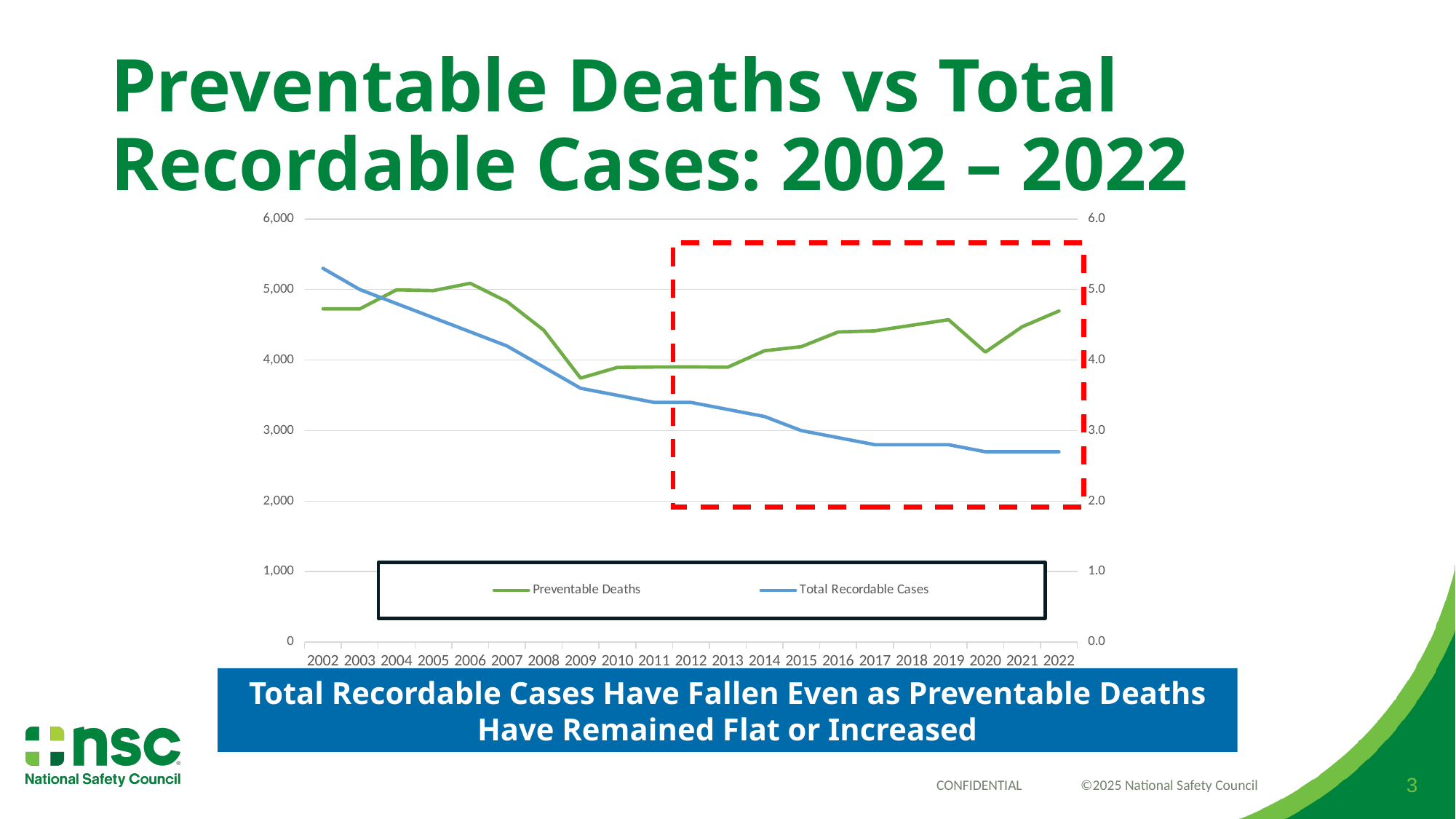
Is the value for Preventable Deaths in 2019 greater or less than 4,000? greater In which year is the Preventable Deaths line at its highest? 2006 How many series does the chart legend list? 2 How many years are plotted along the x axis of the chart? 21 In which year is the Total Recordable Cases line at its highest? 2002 Which series is drawn in green on the chart? Preventable Deaths Is the value for Preventable Deaths in 2009 greater or less than 4,000? less Is the value for Total Recordable Cases in 2022 greater or less than 3.0? less What kind of chart is shown on the slide? line chart In which year is the Preventable Deaths line at its lowest? 2009 Does the Total Recordable Cases line rise or fall from 2002 to 2022? fall